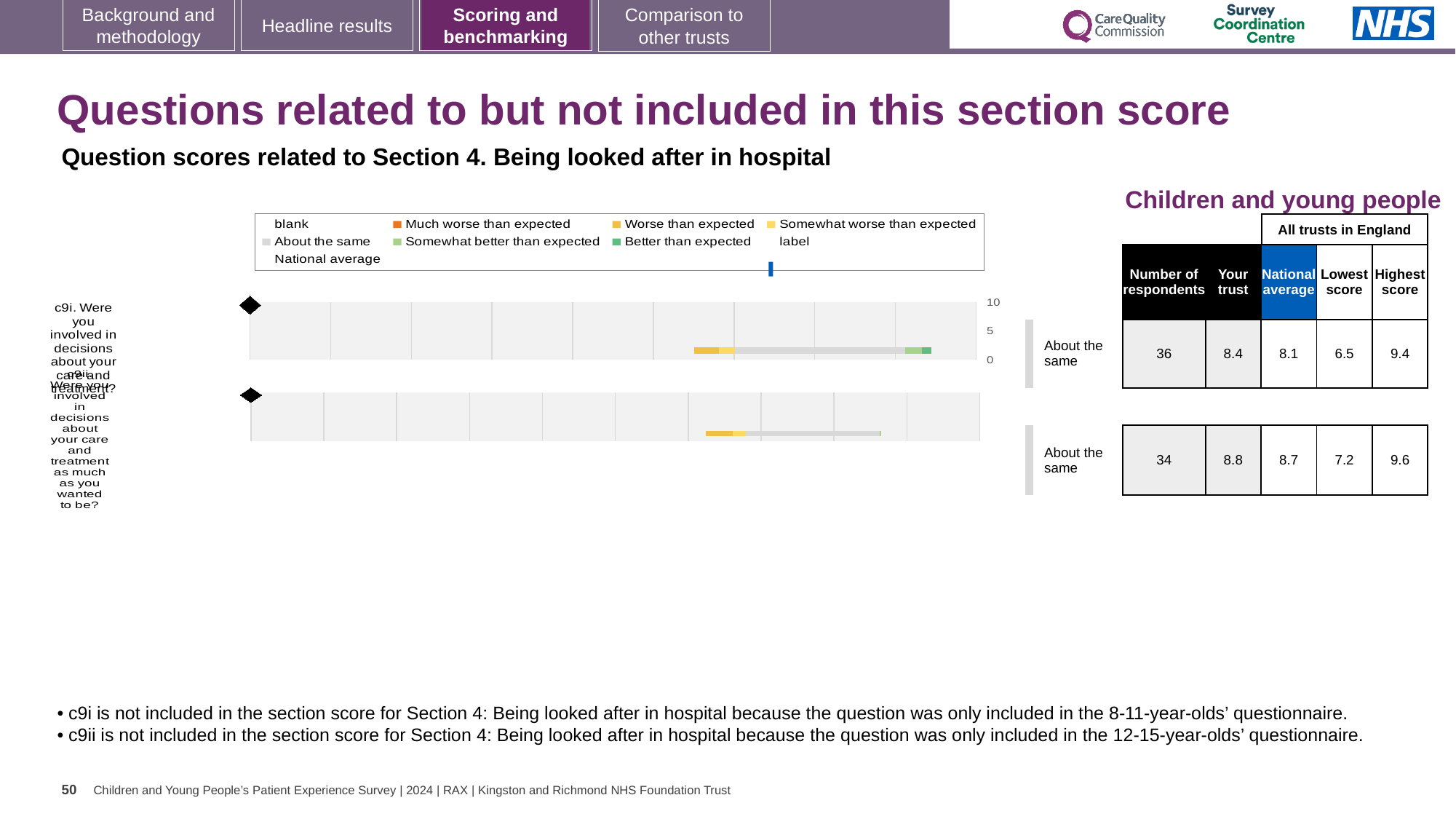
What is the subtitle shown above the chart? Question scores related to Section 4. Being looked after in hospital How many respondents are shown for question c9i? 36 What is the highest score across all trusts in England shown for question c9ii? 9.6 What benchmark category label is shown next to the bar for question c9i? About the same What is the difference between the 'Your trust' score and the national average for question c9ii? 0.1 Which question has the higher 'Your trust' score, c9i or c9ii? c9ii What is the national average score shown for question c9ii? 8.7 What is the difference between the highest score and the lowest score shown for question c9i? 2.9 What is the 'Your trust' score shown for question c9i? 8.4 How many questions (bars) are plotted in the chart? 2 What kind of chart is used to show the question scores for c9i and c9ii? bar chart How many entries does the chart legend list? 9